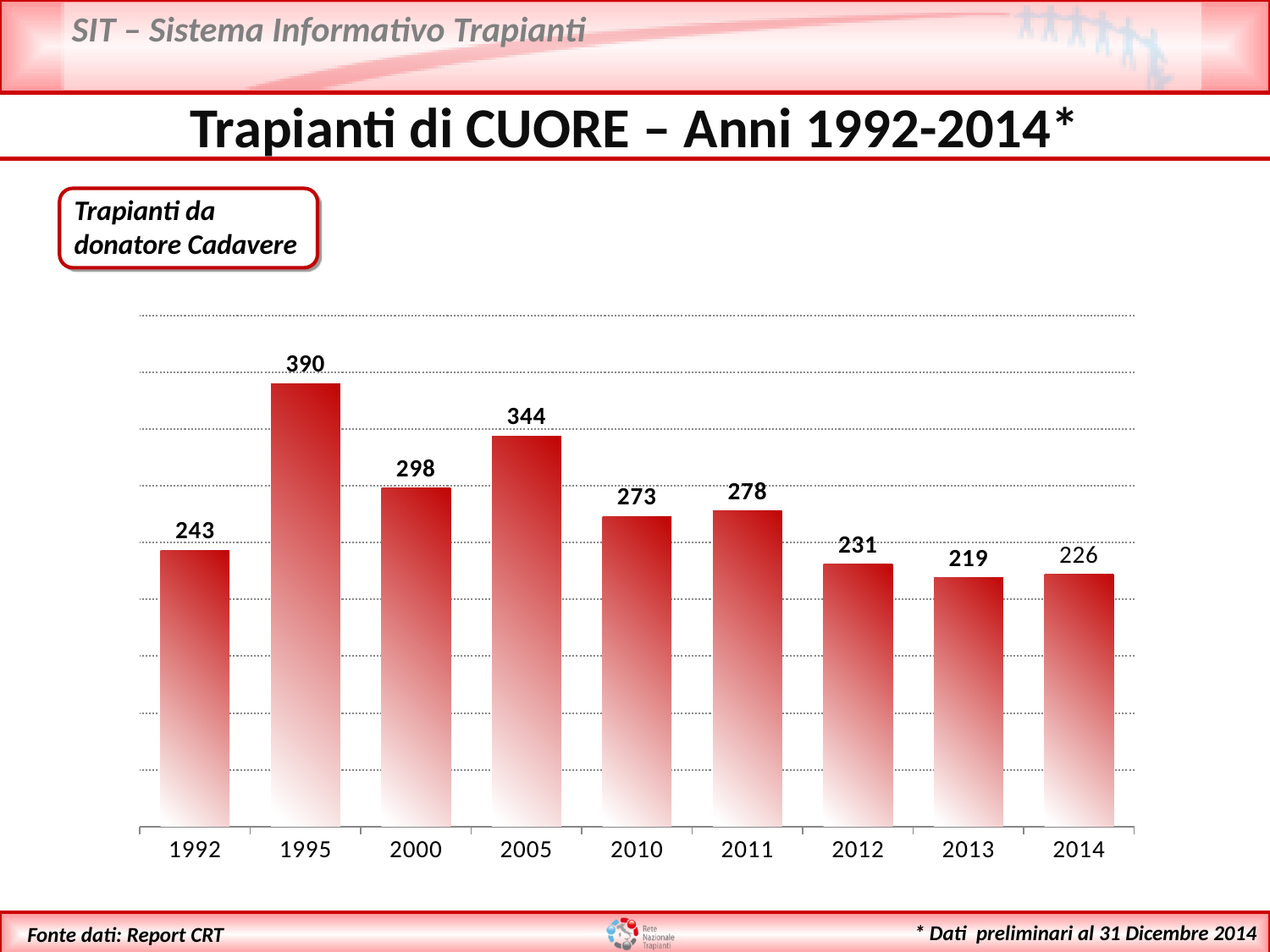
Which is larger, the value for 2010 or the value for 2011? 2011 Which year has the highest value? 1995 What is the difference between the values for 1995 and 2014? 164 What kind of chart is shown on the slide? bar chart What is the value for 2005? 344 Which year has the lowest value? 2013 How many years are shown on the x axis? 9 What is the value for 1995? 390 What is the difference between the values for 2000 and 2010? 25 Do the values rise or fall from 2005 to 2013? fall What is the title of the chart? Trapianti di CUORE – Anni 1992-2014* What is the value for 2013? 219